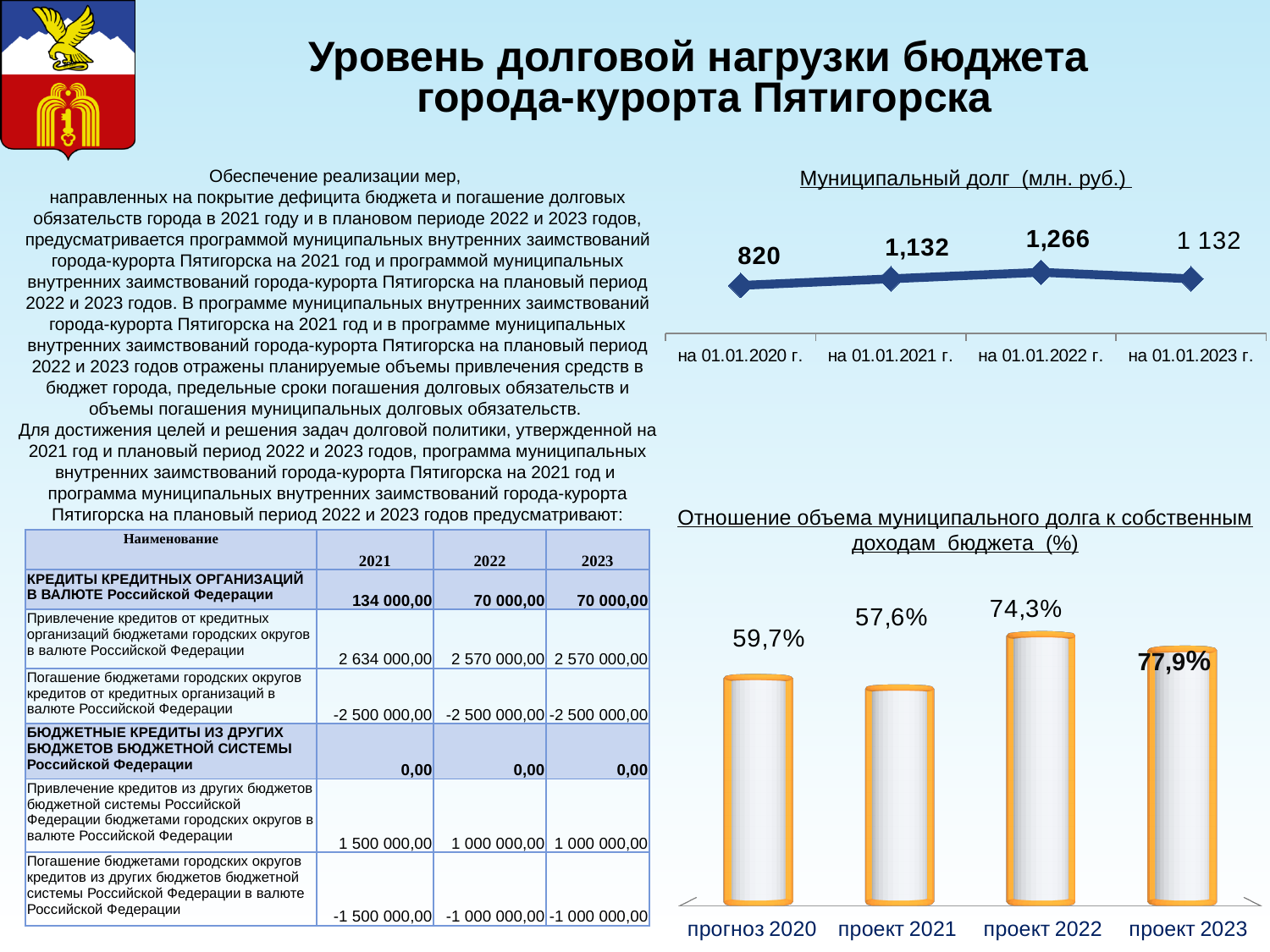
What type of chart is the 'Отношение объема муниципального долга к собственным доходам бюджета (%)' chart? bar chart In the 'Отношение объема муниципального долга к собственным доходам бюджета (%)' chart, how many bars are shown? 4 What type of chart is the 'Муниципальный долг (млн. руб.)' chart? line chart In the 'Муниципальный долг (млн. руб.)' chart, what is the value for на 01.01.2020 г.? 820 In the 'Муниципальный долг (млн. руб.)' chart, how many data points are plotted? 4 In the 'Муниципальный долг (млн. руб.)' chart, what is the value for на 01.01.2022 г.? 1,266 In the 'Отношение объема муниципального долга к собственным доходам бюджета (%)' chart, which category has the lowest value? проект 2021 In the 'Отношение объема муниципального долга к собственным доходам бюджета (%)' chart, what is the value for прогноз 2020? 59,7% In the 'Муниципальный долг (млн. руб.)' chart, which date has the lowest value? на 01.01.2020 г. In the 'Муниципальный долг (млн. руб.)' chart, what is the difference between the values for на 01.01.2021 г. and на 01.01.2020 г.? 312 In the 'Муниципальный долг (млн. руб.)' chart, which date has the highest value? на 01.01.2022 г. In the 'Отношение объема муниципального долга к собственным доходам бюджета (%)' chart, what is the value for проект 2022? 74,3%